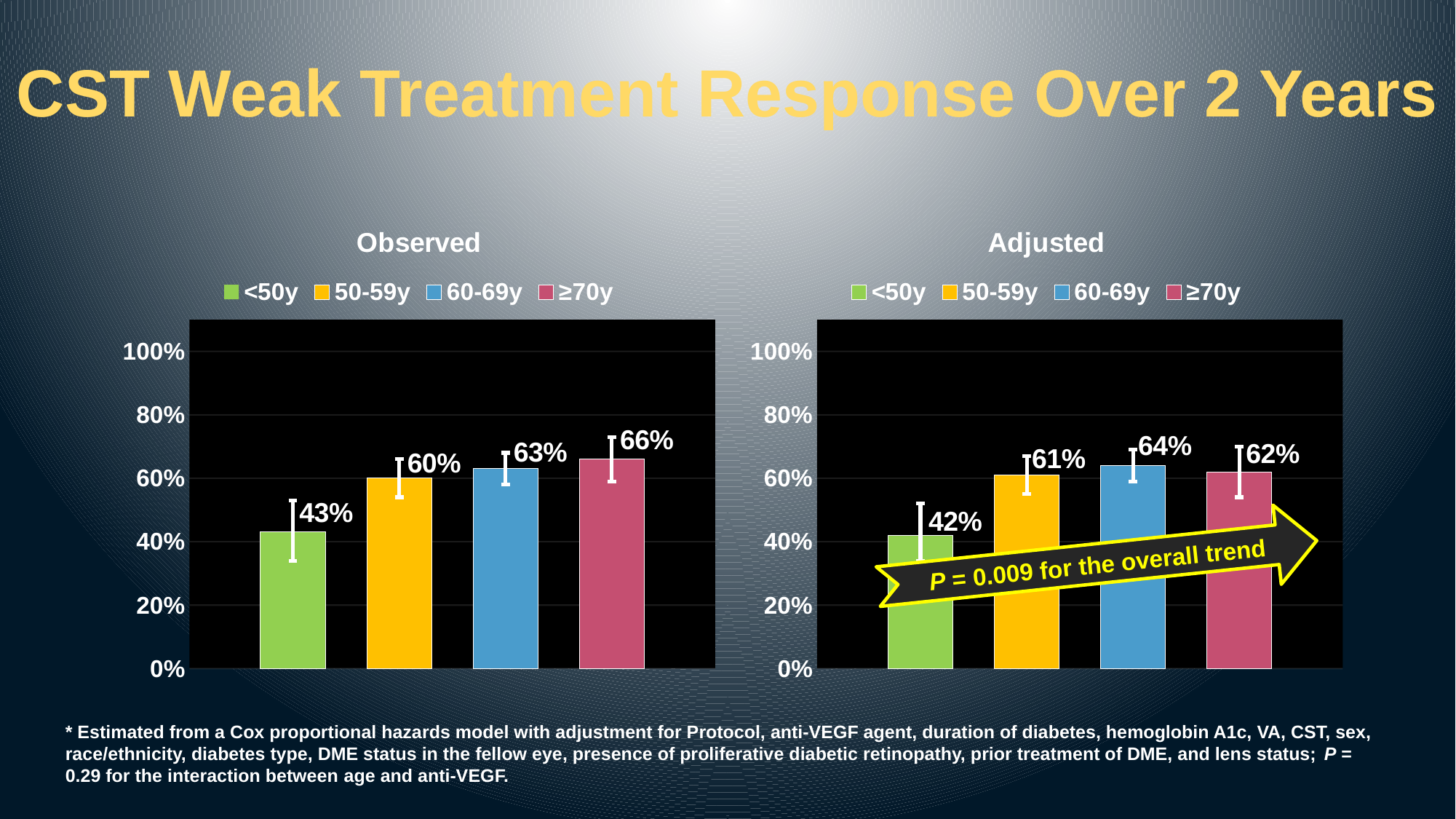
In the Observed chart, do the values rise or fall from the <50y group to the ≥70y group? rise In the Adjusted chart, which is larger, the value for 50-59y or the value for ≥70y? ≥70y What P value is shown for the overall trend in the Adjusted chart? P = 0.009 In the Observed chart, what is the difference between the ≥70y value and the <50y value? 23% How many age groups are plotted in the Adjusted chart? 4 What kind of chart is the Observed chart? bar chart In the Observed chart, what is the value for the <50y group? 43% In the Adjusted chart, which age group has the lowest value? <50y In the Observed chart, which age group has the highest value? ≥70y In the Adjusted chart, what is the value for the 60-69y group? 64% How many entries does the legend of the Observed chart list? 4 In the Observed chart, is the value for 50-59y greater or less than 40%? greater